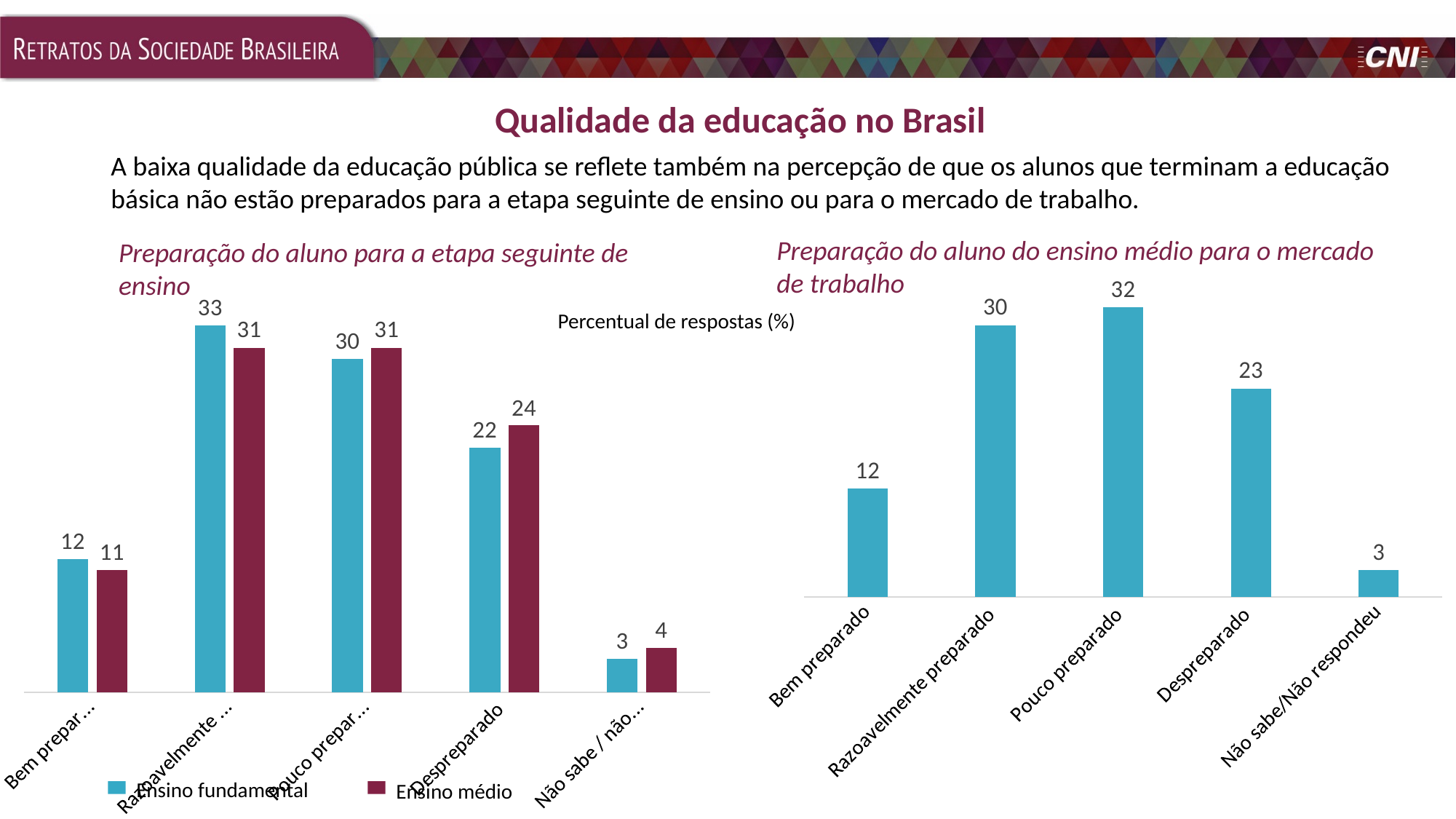
In the chart 'Preparação do aluno para a etapa seguinte de ensino', what is the value for 'Ensino médio' in the 'Despreparado' category? 24 In the chart 'Preparação do aluno para a etapa seguinte de ensino', which is larger for 'Despreparado': 'Ensino fundamental' or 'Ensino médio'? Ensino médio In the chart 'Preparação do aluno do ensino médio para o mercado de trabalho', how many categories are shown? 5 In the chart 'Preparação do aluno do ensino médio para o mercado de trabalho', what is the value for 'Despreparado'? 23 In the chart 'Preparação do aluno do ensino médio para o mercado de trabalho', what is the difference between 'Razoavelmente preparado' and 'Bem preparado'? 18 In the chart 'Preparação do aluno do ensino médio para o mercado de trabalho', which category has the highest value? Pouco preparado In the chart 'Preparação do aluno para a etapa seguinte de ensino', what is the value for 'Ensino fundamental' in the 'Despreparado' category? 22 In the chart 'Preparação do aluno do ensino médio para o mercado de trabalho', which category has the lowest value? Não sabe/Não respondeu In the chart 'Preparação do aluno do ensino médio para o mercado de trabalho', what is the value for 'Pouco preparado'? 32 In the chart 'Preparação do aluno para a etapa seguinte de ensino', what is the highest value shown for 'Ensino fundamental'? 33 What kind of chart is 'Preparação do aluno do ensino médio para o mercado de trabalho'? Bar chart In the chart 'Preparação do aluno para a etapa seguinte de ensino', how many series does the legend list? 2